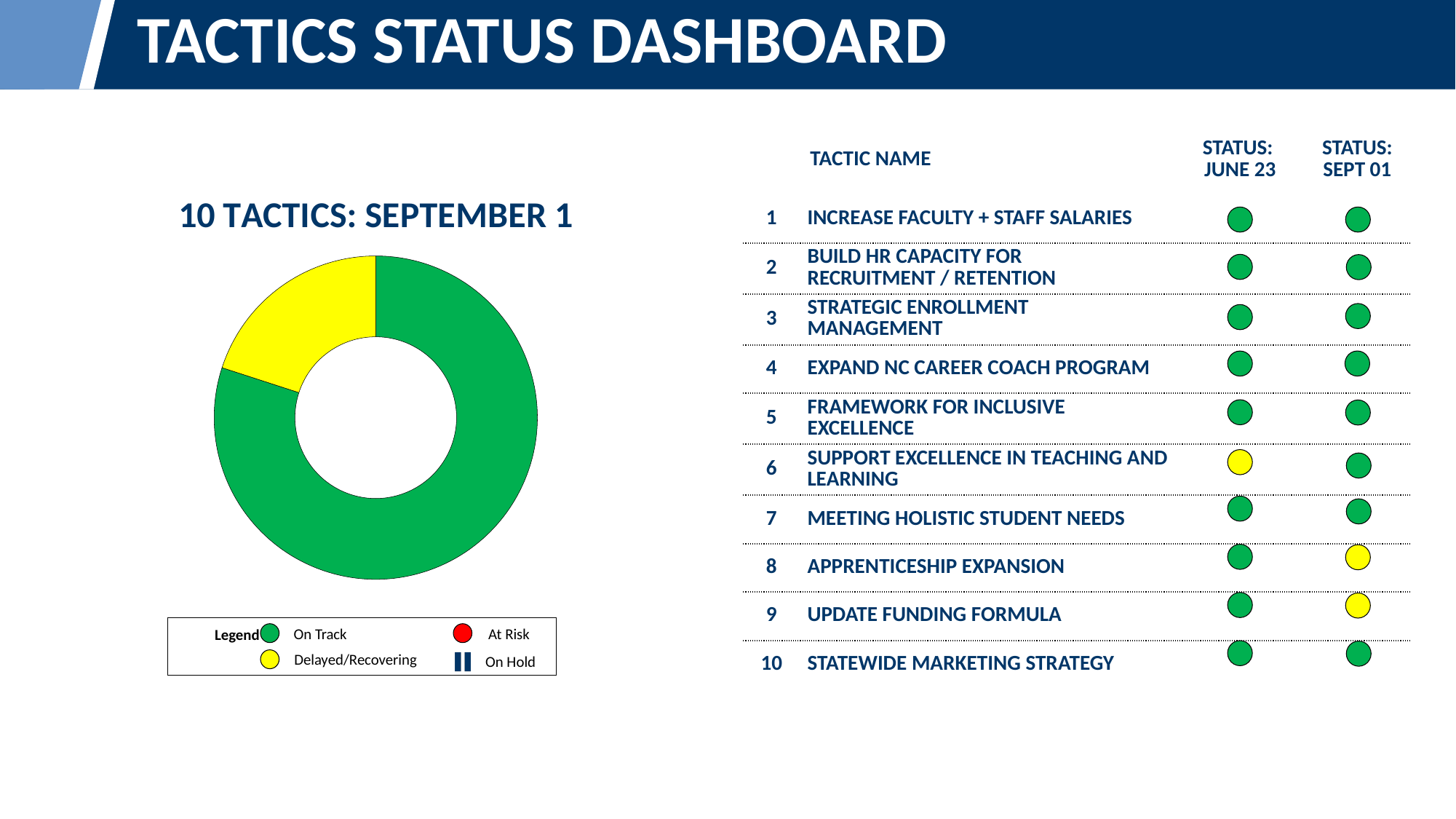
How many slices does the donut chart have? 2 What kind of chart is shown on the left of the slide? Donut chart According to the legend, what status does the yellow colour represent? Delayed/Recovering Which slice of the donut chart is the largest? On Track (green) Does the green slice of the donut chart cover more or less than half of the chart? More Which slice of the donut chart is the smallest? Delayed/Recovering (yellow) In the donut chart, is the green slice larger or smaller than the yellow slice? Larger What is the title of the chart on the left of the slide? 10 TACTICS: SEPTEMBER 1 Which two status colours from the legend actually appear in the donut chart? Green and yellow